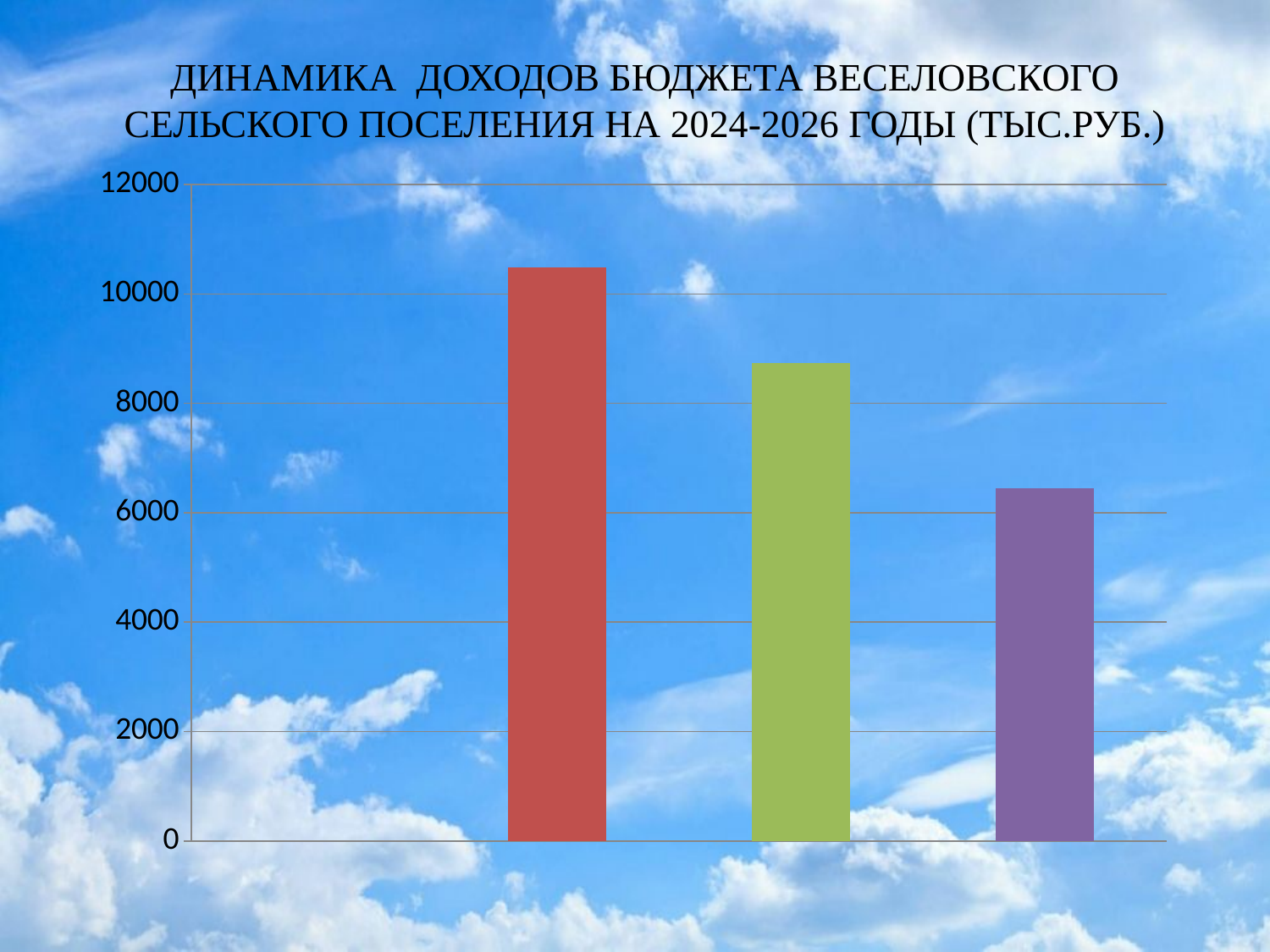
Which bar is the shortest: the red (first), green (second) or purple (third)? purple (third) Is the value of the green (second) bar greater or less than 10000? less Which is larger, the value of the green (second) bar or the purple (third) bar? green (second) bar In what units are the budget revenues expressed according to the chart title? тыс.руб. Which bar is the tallest: the red (first), green (second) or purple (third)? red (first) What is the highest value shown on the vertical axis of the chart? 12000 Do the bar values rise or fall from left to right across the chart? fall Is the value of the green (second) bar greater or less than 8000? greater What kind of chart is shown on the slide? bar chart How many bars are plotted in the chart? 3 Is the value of the purple (third) bar greater or less than 6000? greater